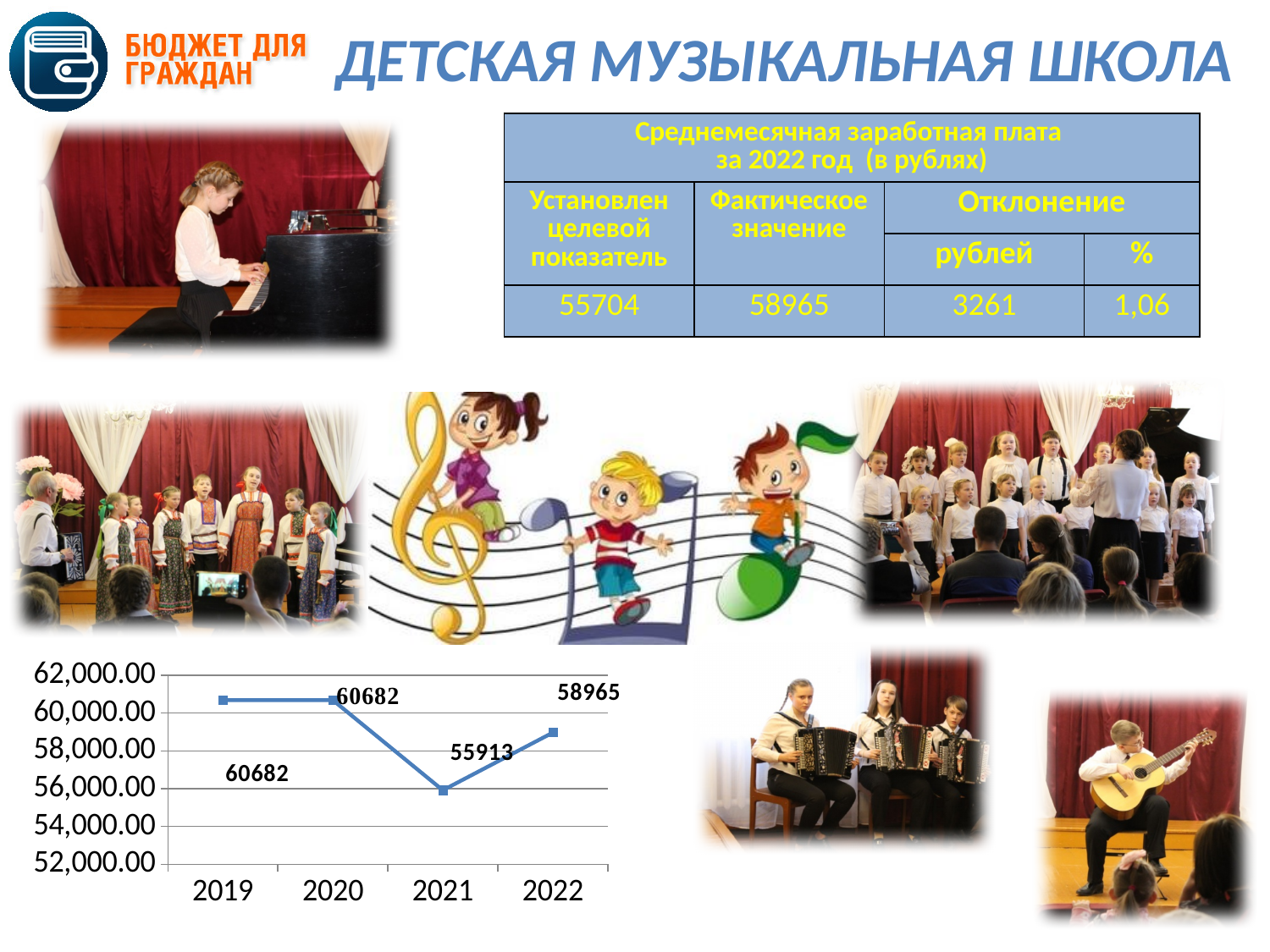
How many years are plotted on the x axis of the line chart? 4 What is the value for 2022 in the line chart? 58965 What is the difference between the 2022 value and the 2021 value in the line chart? 3052 What is the difference between the 2020 value and the 2021 value in the line chart? 4769 What type of chart is shown at the bottom left of the slide? line chart In the line chart, is the value for 2020 or 2022 larger? 2020 What is the value for 2020 in the line chart? 60682 Does the line chart rise or fall from 2021 to 2022? rise Is the value for 2021 in the line chart greater or less than 56,000.00? less Does the line chart rise or fall from 2020 to 2021? fall What is the value for 2021 in the line chart? 55913 Which year has the lowest value in the line chart? 2021